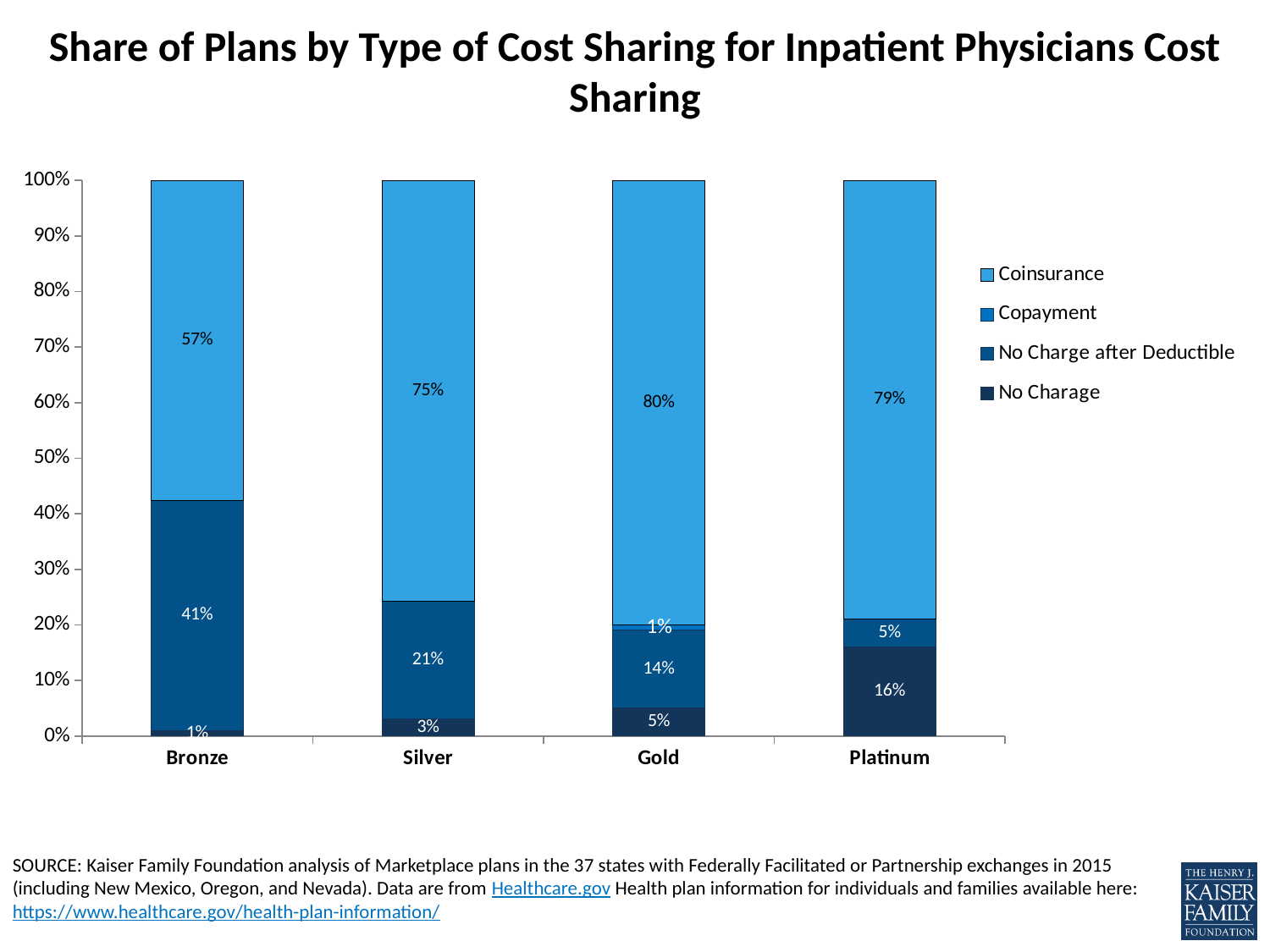
What is the Coinsurance share for Bronze plans? 57% Which series is listed first in the legend? Coinsurance What is the Coinsurance share for Gold plans? 80% What is the No Charge after Deductible share for Gold plans? 14% Which plan type has the lowest Coinsurance share? Bronze What kind of chart is shown on the slide? Stacked bar chart How many series does the legend list? 4 How many plan types (categories) are shown on the x axis? 4 What is the difference between the Coinsurance share for Silver and for Bronze? 18 percentage points Which plan type has the highest Coinsurance share? Gold Which has a larger No Charge after Deductible share, Bronze or Silver? Bronze What is the No Charge share for Platinum plans? 16%